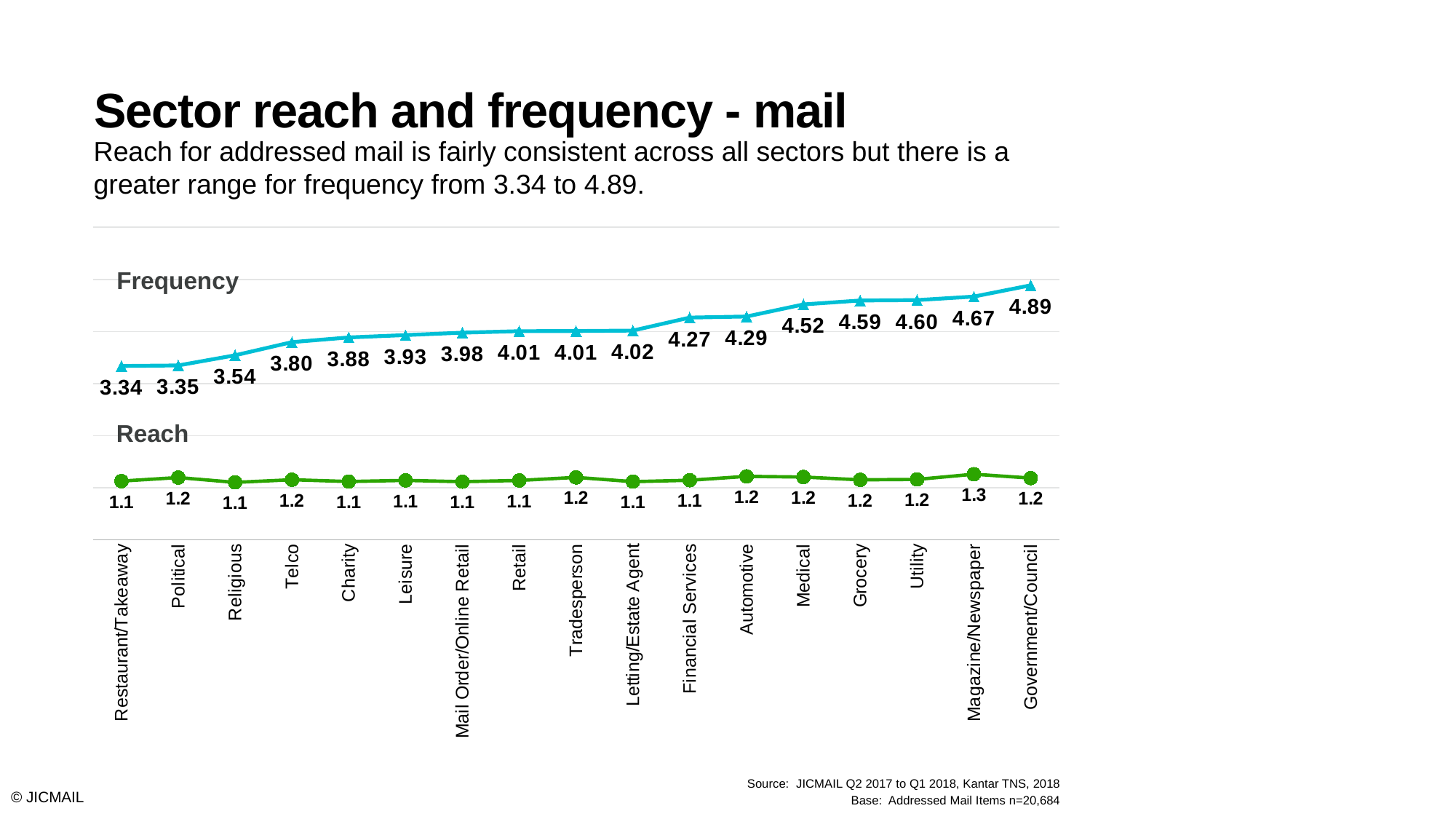
What is the Reach value for Magazine/Newspaper? 1.3 What is the difference between the Frequency values for Medical and Automotive? 0.23 Which sector has the highest Reach value? Magazine/Newspaper What is the difference between the Frequency values for Government/Council and Restaurant/Takeaway? 1.55 Which sector has the highest Frequency value? Government/Council What is the Frequency value for Charity? 3.88 Which sector has the lowest Frequency value? Restaurant/Takeaway What type of chart is shown on the slide? Line chart How many sectors are shown on the x axis? 17 Which has a higher Frequency value, Financial Services or Telco? Financial Services How many data series are plotted on the chart? 2 What is the Frequency value for Medical? 4.52